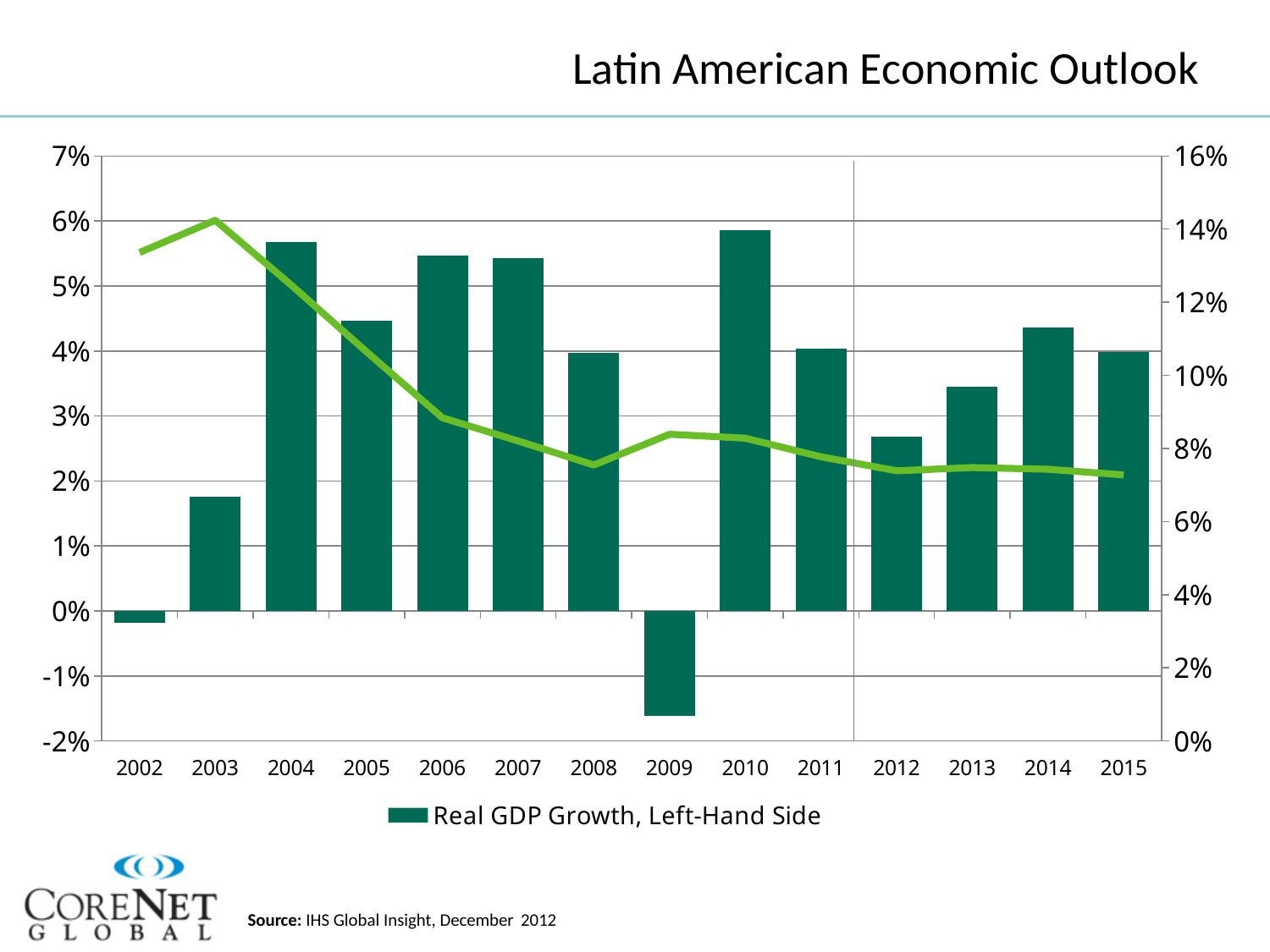
How many series does the legend list? 1 Which year has the larger Real GDP Growth bar, 2013 or 2014? 2014 Is the Real GDP Growth value for 2003 greater or less than 2%? less How many years are shown on the x axis of the chart? 14 Is the Real GDP Growth value for 2013 greater or less than 4%? less Is the Real GDP Growth value for 2004 greater or less than 5%? greater Which year has the larger Real GDP Growth bar, 2005 or 2006? 2006 Does the green line rise or fall from 2003 to 2008? fall What is the title of the slide's chart? Latin American Economic Outlook What kind of chart is shown on the slide? bar chart with a line Which year has the lowest Real GDP Growth bar? 2009